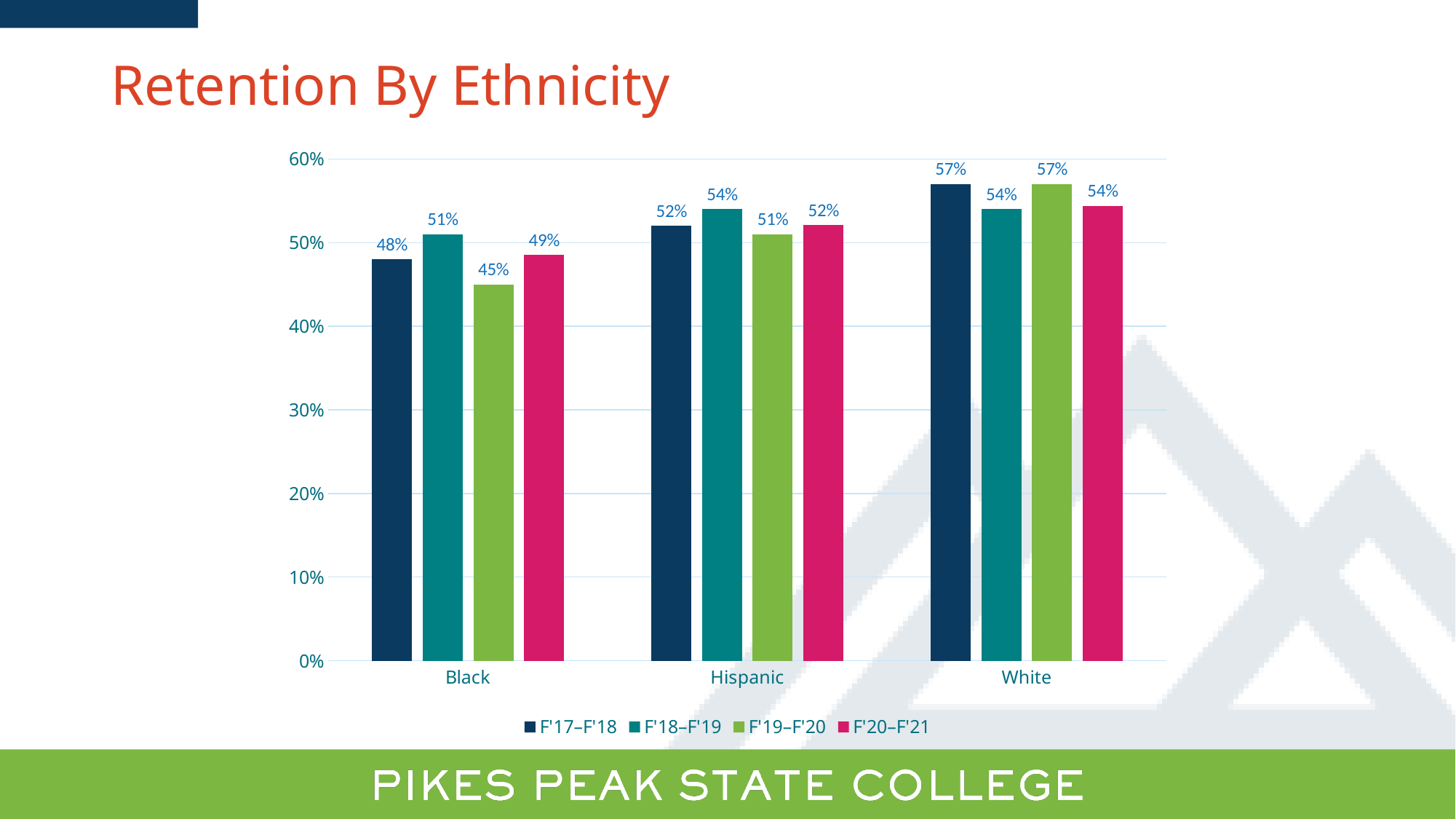
Which ethnicity has the lowest retention rate in F'19–F'20? Black Which is larger, the Hispanic retention rate in F'18–F'19 or the Black retention rate in F'18–F'19? Hispanic What is the retention rate for White students in F'20–F'21? 54% What is the retention rate for Hispanic students in F'18–F'19? 54% What is the retention rate for Black students in F'17–F'18? 48% Which colour represents the F'20–F'21 series in the legend? Pink What kind of chart is shown on the slide? Bar chart How many ethnicity categories are shown on the x axis? 3 What is the difference between the White and Black retention rates in F'19–F'20? 12% What is the title of the chart? Retention By Ethnicity How many series does the legend list? 4 Which ethnicity has the highest retention rate in F'17–F'18? White